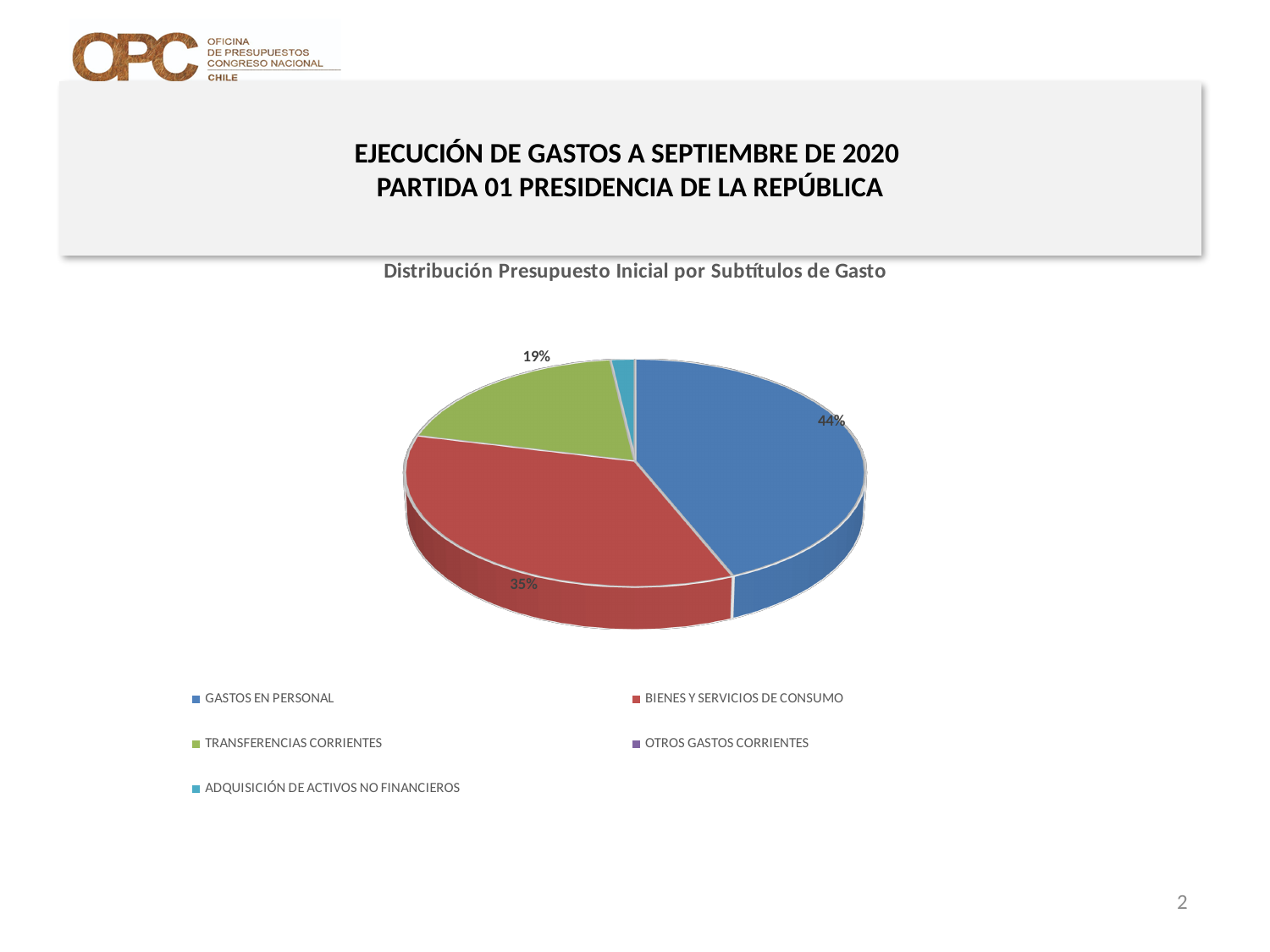
What kind of chart is shown on the slide? pie chart What is the difference in percentage points between the GASTOS EN PERSONAL slice and the BIENES Y SERVICIOS DE CONSUMO slice? 9 percentage points What colour is the slice for TRANSFERENCIAS CORRIENTES? green How many categories does the legend list? 5 What share of the pie does TRANSFERENCIAS CORRIENTES represent? 19% What share of the pie does GASTOS EN PERSONAL represent? 44% What share of the pie does BIENES Y SERVICIOS DE CONSUMO represent? 35% Is the share for GASTOS EN PERSONAL greater or less than 50%? less Which is larger, the slice for BIENES Y SERVICIOS DE CONSUMO or the slice for TRANSFERENCIAS CORRIENTES? BIENES Y SERVICIOS DE CONSUMO What is the title of the chart? Distribución Presupuesto Inicial por Subtítulos de Gasto Which category has the largest slice of the pie? GASTOS EN PERSONAL